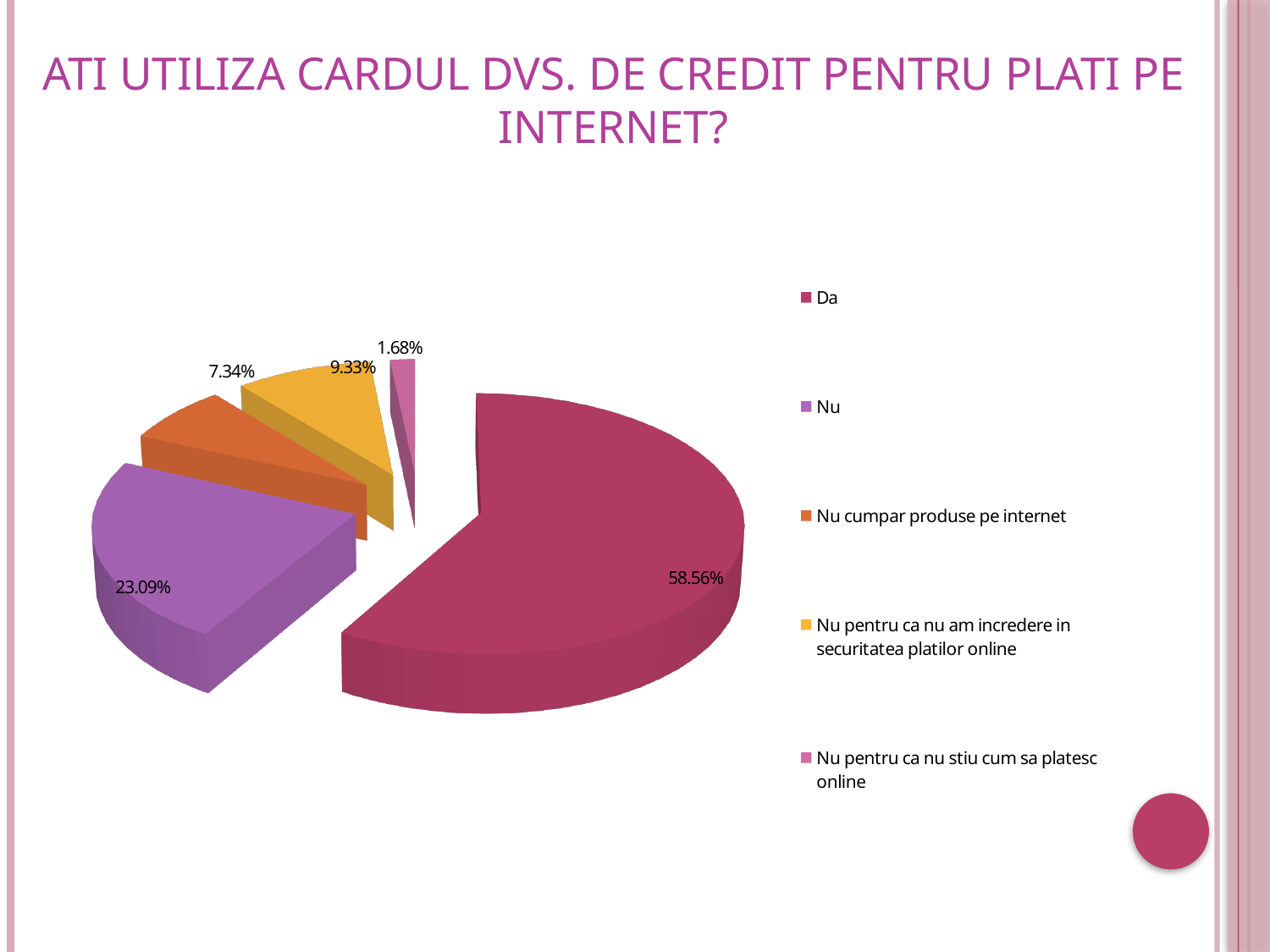
What kind of chart is shown on the slide? pie chart What is the value for "Nu cumpar produse pe internet"? 7.34% Which category has the largest share of the pie? Da What is the value for "Nu pentru ca nu am incredere in securitatea platilor online"? 9.33% How many categories does the legend list? 5 What is the value for "Nu pentru ca nu stiu cum sa platesc online"? 1.68% What is the difference between the "Da" and "Nu" shares? 35.47% What percentage of respondents answered "Nu"? 23.09% What percentage of respondents answered "Da"? 58.56% What colour is the slice for "Nu"? purple Which is larger: "Nu cumpar produse pe internet" or "Nu pentru ca nu am incredere in securitatea platilor online"? Nu pentru ca nu am incredere in securitatea platilor online Which category has the smallest share of the pie? Nu pentru ca nu stiu cum sa platesc online